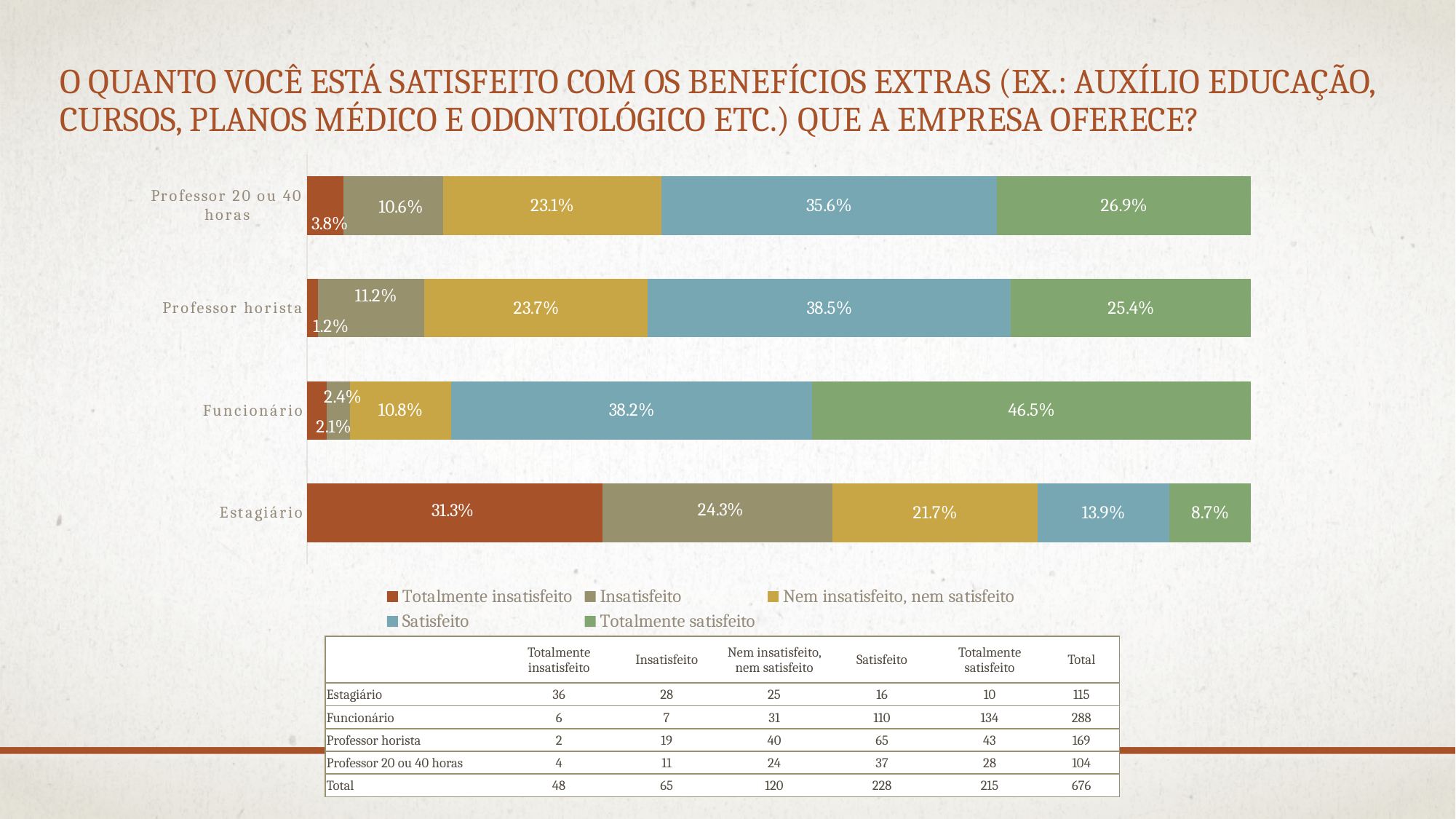
Which response is the largest segment of the Estagiário bar? Totalmente insatisfeito What colour represents Totalmente satisfeito in the chart? Green Which has a larger Nem insatisfeito, nem satisfeito share: Professor horista or Professor 20 ou 40 horas? Professor horista What percentage of Funcionário respondents answered Satisfeito? 38.2% What kind of chart is shown on the slide? Stacked bar chart How many series does the legend list? 5 What is the difference between the Satisfeito shares of Professor horista and Professor 20 ou 40 horas? 2.9 percentage points What is the Insatisfeito value for Professor 20 ou 40 horas? 10.6% What is the Totalmente insatisfeito share for Estagiário? 31.3% How many categories (bars) are shown in the chart? 4 Which category has the lowest Totalmente insatisfeito share? Professor horista Which category has the highest Totalmente satisfeito share? Funcionário